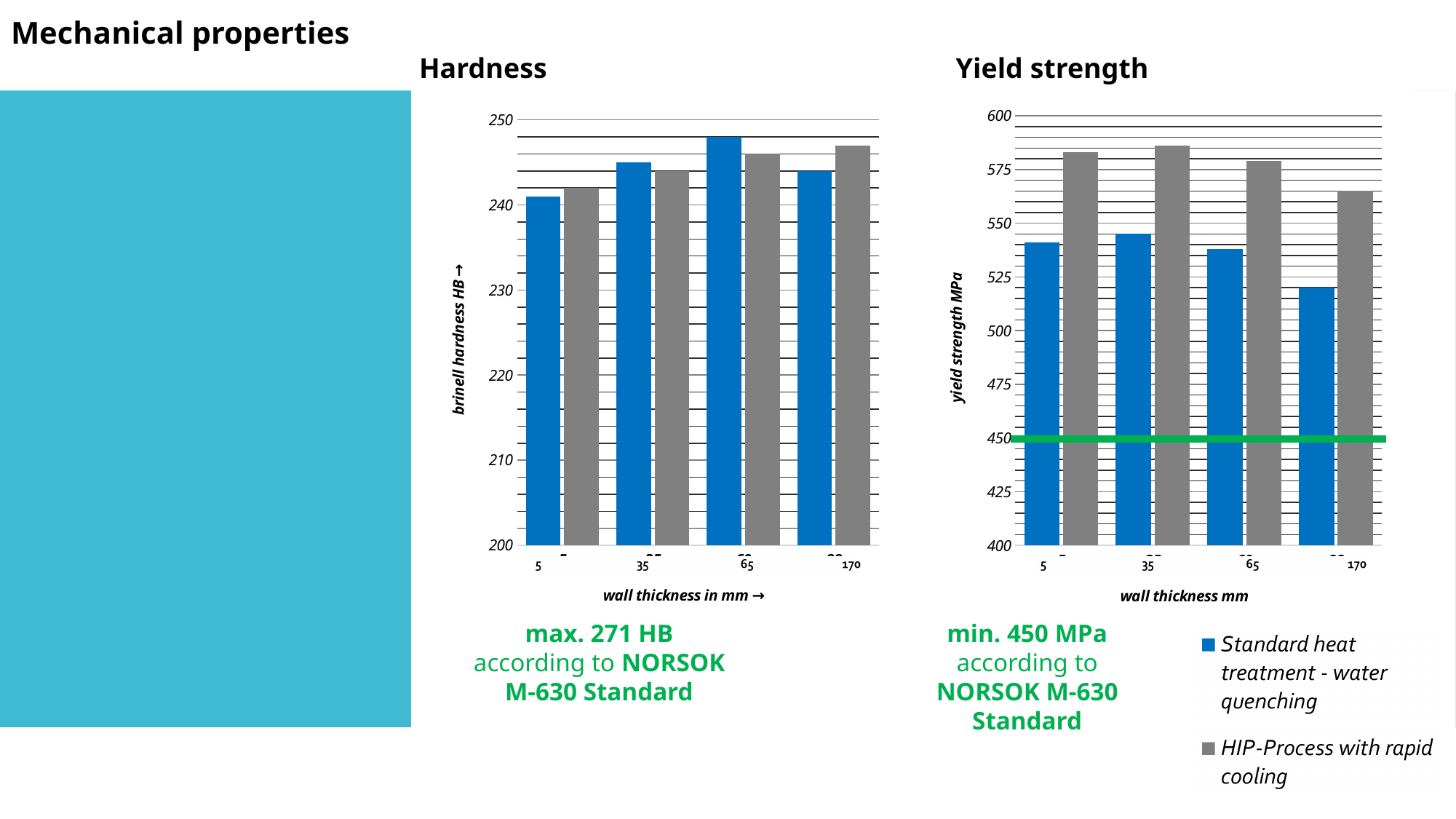
How many wall thickness categories are shown on the Yield strength chart? 4 On the Hardness chart, at which wall thickness is the Standard heat treatment - water quenching bar lowest? 5 What value does the green horizontal line on the Yield strength chart mark? 450 What kind of chart is the Hardness chart? bar chart On the Yield strength chart, at which wall thickness is the Standard heat treatment - water quenching bar lowest? 170 On the Yield strength chart at 65 mm wall thickness, which series has the larger value: Standard heat treatment - water quenching or HIP-Process with rapid cooling? HIP-Process with rapid cooling On the Yield strength chart, at which wall thickness is the HIP-Process with rapid cooling bar lowest? 170 How many series does the legend list for the charts? 2 On the Yield strength chart, is the Standard heat treatment - water quenching value at 170 mm greater or less than 550? less On the Yield strength chart, do the HIP-Process with rapid cooling bars rise or fall from 35 mm to 170 mm? fall On the Yield strength chart, is the HIP-Process with rapid cooling value at 35 mm greater or less than 575? greater On the Hardness chart, at which wall thickness is the Standard heat treatment - water quenching bar highest? 65